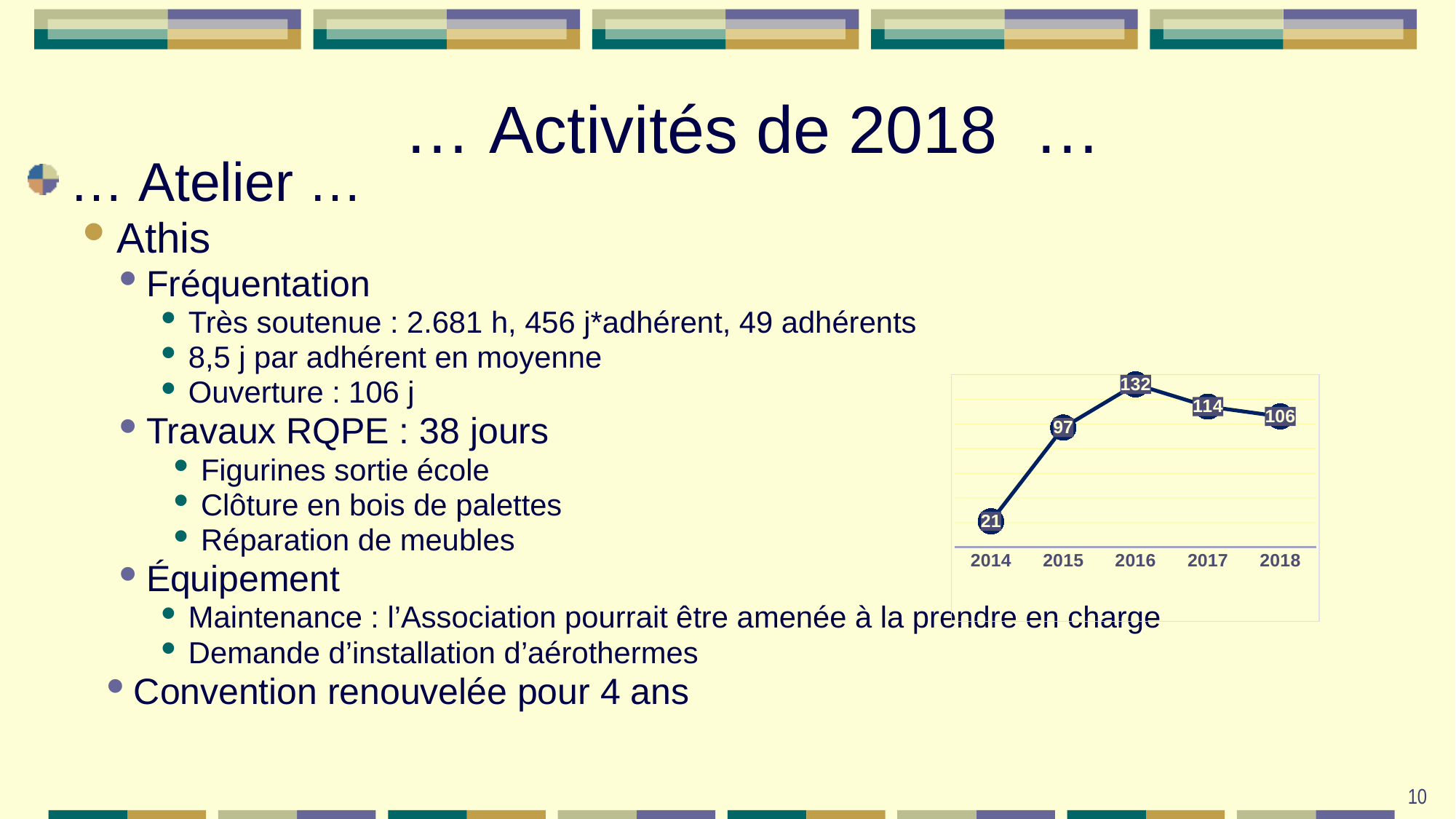
Which is larger, the value for 2017 or the value for 2018? 2017 What is the difference between the values for 2015 and 2014? 76 What is the value plotted for 2018? 106 How many years are plotted on the chart? 5 Do the values rise or fall from 2014 to 2016? rise What is the difference between the values for 2016 and 2017? 18 Which year has the lowest value on the chart? 2014 What is the value plotted for 2014? 21 Which year has the highest value on the chart? 2016 Do the values rise or fall from 2016 to 2018? fall What is the value plotted for 2016? 132 What kind of chart is shown on the slide? line chart